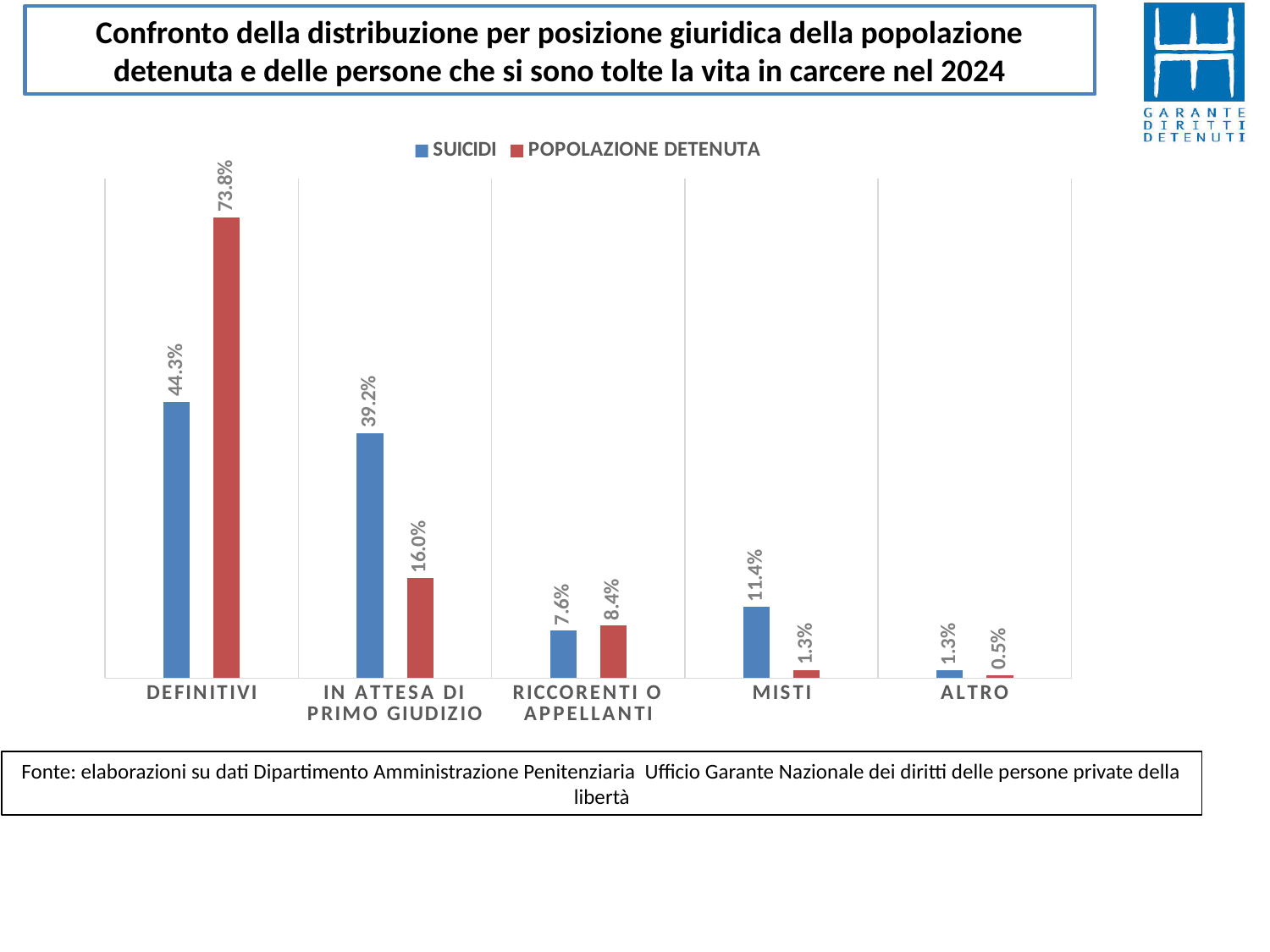
What is the SUICIDI value for DEFINITIVI? 44.3% How many series does the legend list? 2 How many categories are shown on the x axis? 5 What is the difference between the POPOLAZIONE DETENUTA and SUICIDI values for DEFINITIVI? 29.5% What is the POPOLAZIONE DETENUTA value for ALTRO? 0.5% Which colour represents the SUICIDI series? Blue What kind of chart is shown on the slide? Bar chart For RICCORENTI O APPELLANTI, which series has the larger value, SUICIDI or POPOLAZIONE DETENUTA? POPOLAZIONE DETENUTA What is the SUICIDI value for MISTI? 11.4% Which category has the lowest SUICIDI value? ALTRO Which category has the highest POPOLAZIONE DETENUTA value? DEFINITIVI What is the POPOLAZIONE DETENUTA value for IN ATTESA DI PRIMO GIUDIZIO? 16.0%